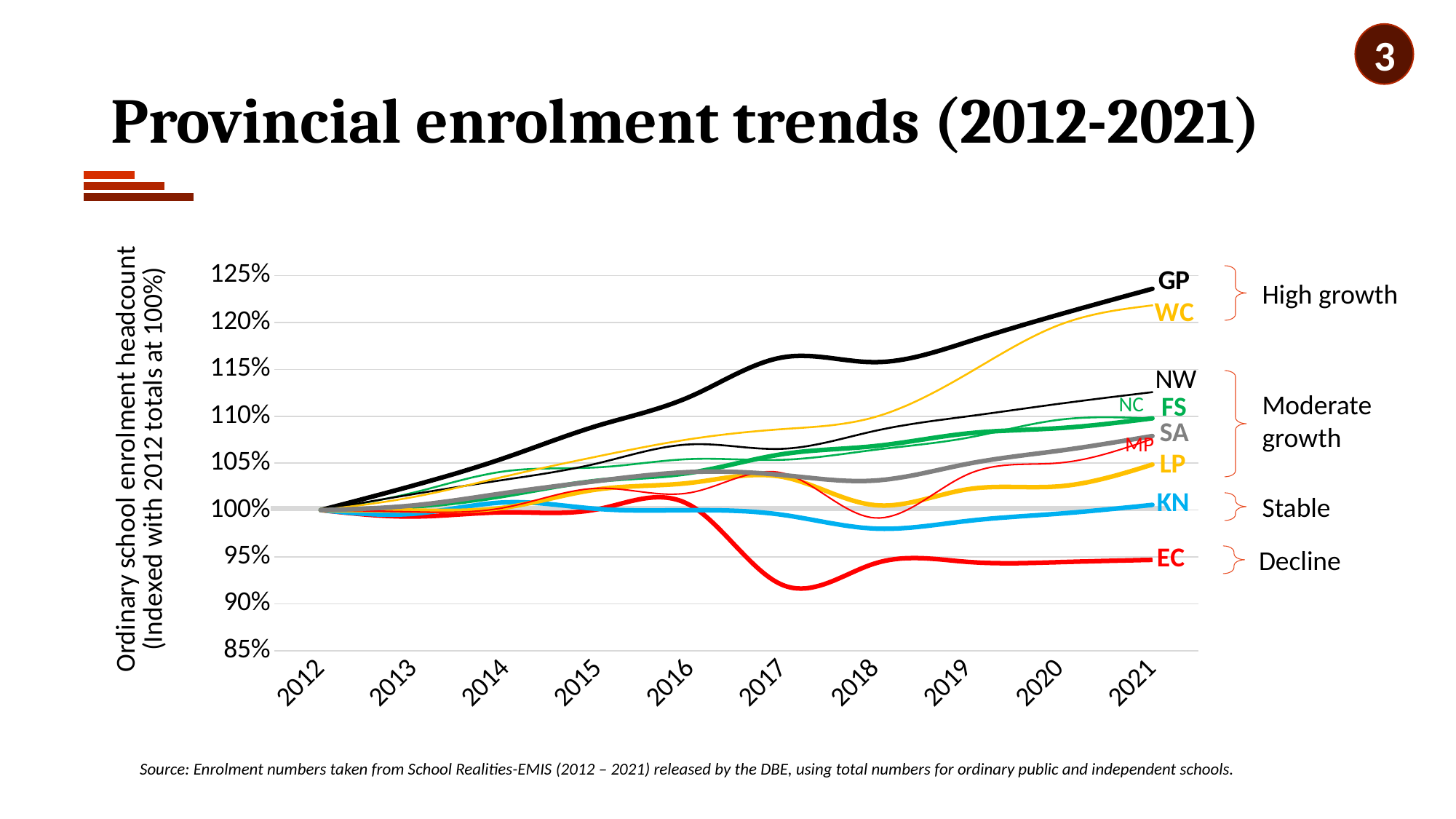
How many years are shown along the x axis of the chart? 10 What is the title of the chart on the slide? Provincial enrolment trends (2012-2021) Does the GP line rise or fall from 2012 to 2021? Rise Is the value for GP in 2021 greater or less than 120%? greater Is the value for EC in 2021 greater or less than 100%? less Is the value for EC in 2017 greater or less than 95%? less How many provinces are plotted as lines on the chart? 10 Which province has the lowest indexed enrolment in 2021? EC What kind of chart is shown on the slide? Line chart In 2021, which is larger: the value for WC or the value for KN? WC Which province has the highest indexed enrolment in 2021? GP